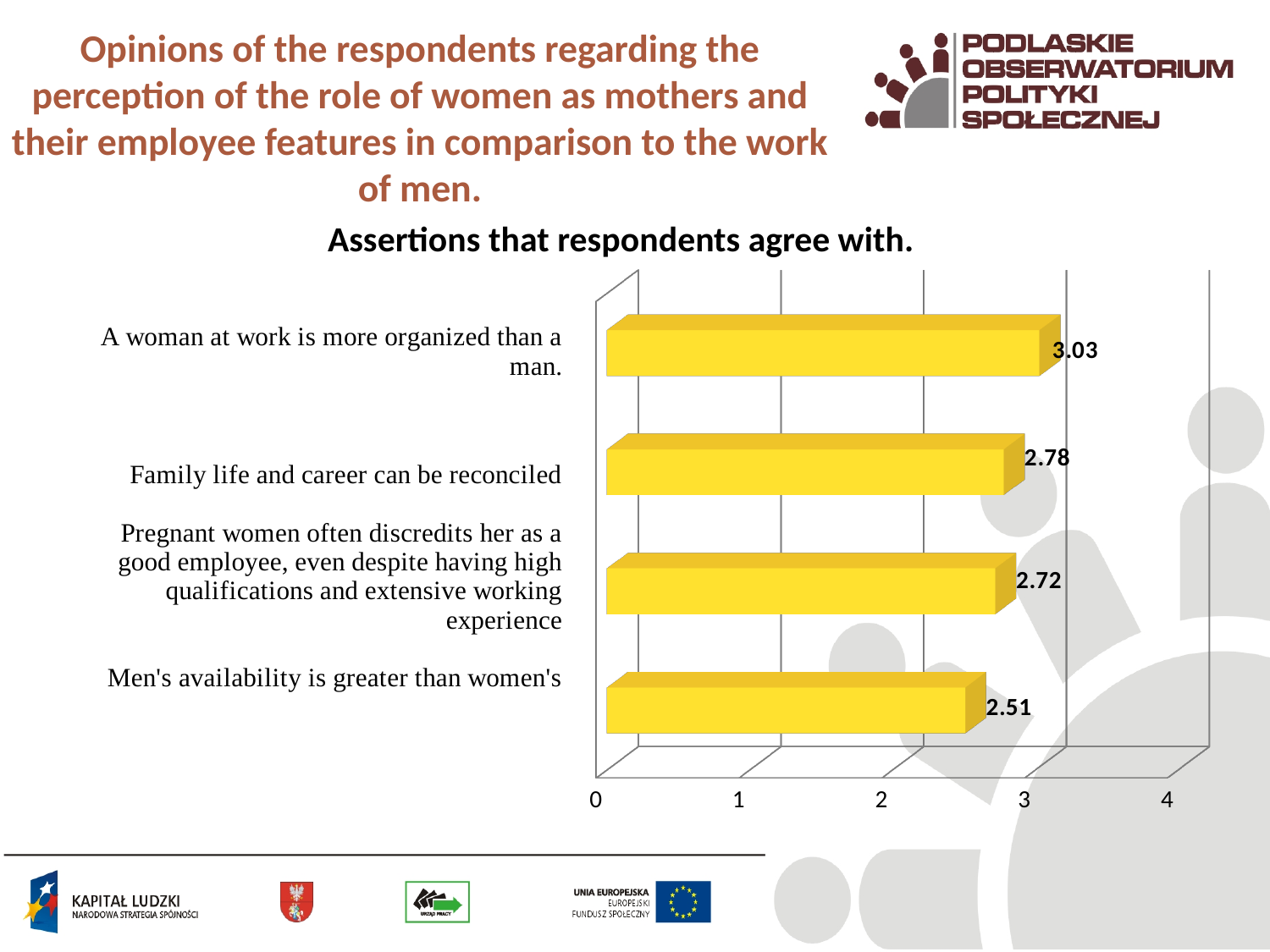
Is the value for "A woman at work is more organized than a man." greater or less than 3? greater What kind of chart is shown on the slide? bar chart What is the value for "Men's availability is greater than women's"? 2.51 Which has a larger value: "Family life and career can be reconciled" or "Men's availability is greater than women's"? Family life and career can be reconciled How many assertions are plotted in the chart? 4 What is the value for "Family life and career can be reconciled"? 2.78 What is the value for the assertion that a pregnant woman often discredits herself as a good employee? 2.72 Which assertion has the lowest value? Men's availability is greater than women's What is the title of the chart? Assertions that respondents agree with. Which assertion has the highest value? A woman at work is more organized than a man. What is the difference between the values for "A woman at work is more organized than a man." and "Men's availability is greater than women's"? 0.52 What is the value for "A woman at work is more organized than a man."? 3.03